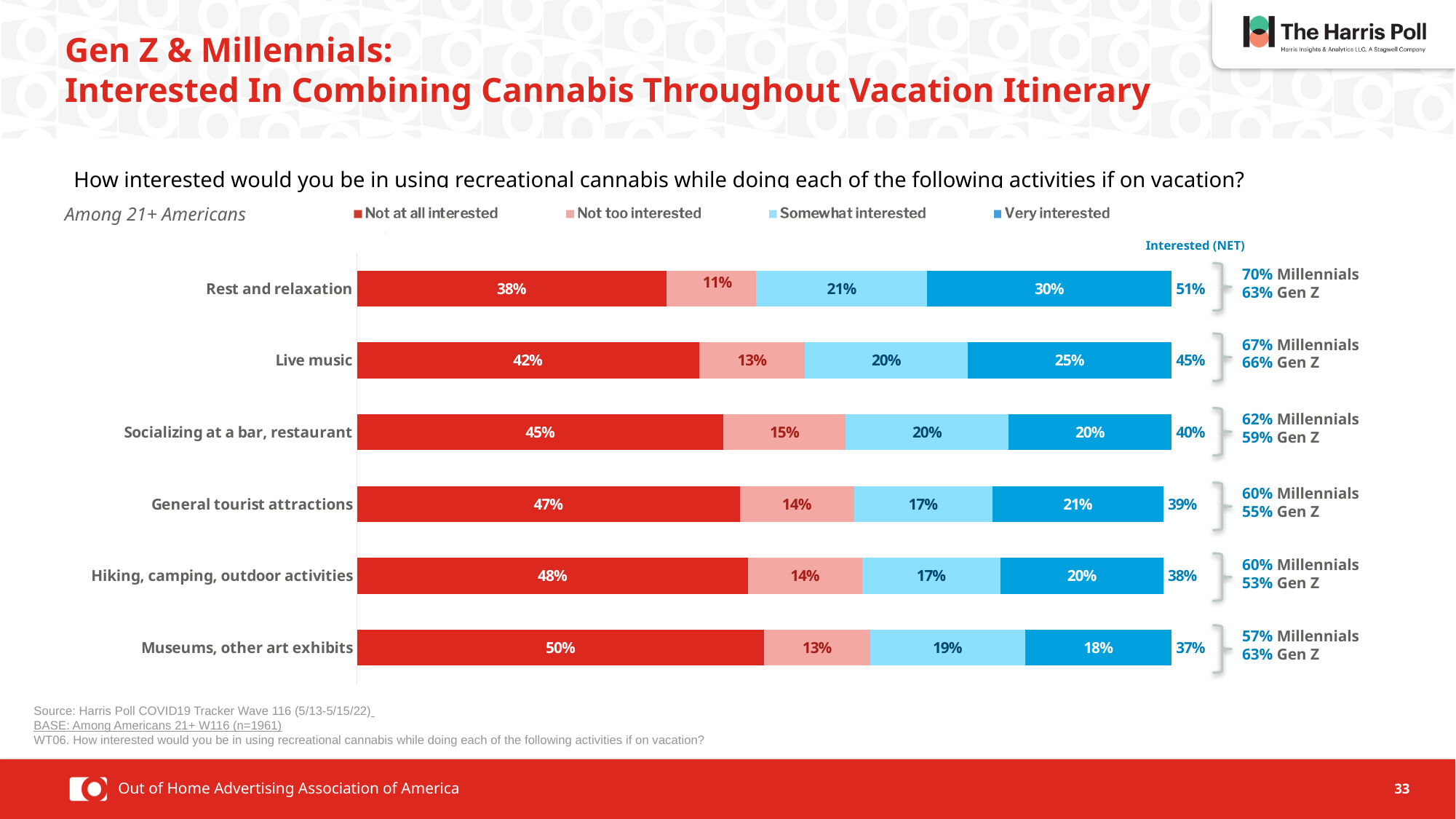
How many series does the legend list? 4 What is the difference between the "Very interested" percentages for rest and relaxation and for museums, other art exhibits? 12% Which is larger: the "Somewhat interested" share for rest and relaxation or for general tourist attractions? Rest and relaxation What percentage of respondents are "Very interested" in using recreational cannabis at live music? 25% Which activity has the lowest Interested (NET) value? Museums, other art exhibits Which legend entry is shown in the darkest red colour? Not at all interested What kind of chart is shown on the slide? Stacked bar chart What is the Interested (NET) value for museums, other art exhibits? 37% Which activity has the highest "Not at all interested" percentage? Museums, other art exhibits What is the Interested (NET) value for Millennials for rest and relaxation? 70% How many activities are shown in the chart? 6 What percentage of respondents are "Not at all interested" in using recreational cannabis during rest and relaxation? 38%